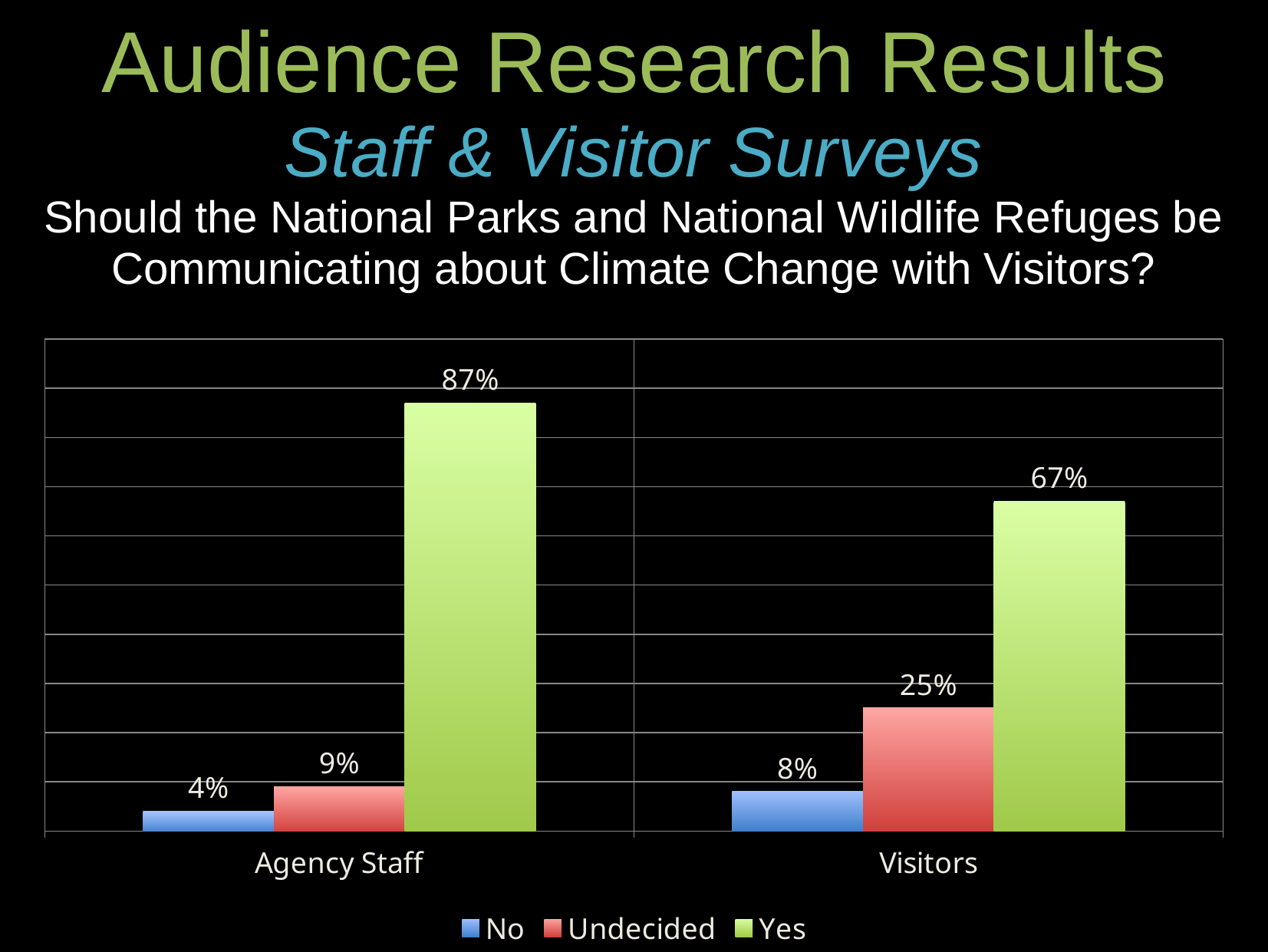
What percentage of Visitors answered Undecided? 25% How many series does the legend list? 3 What percentage of Visitors answered Yes? 67% Which response was lowest among Agency Staff? No What kind of chart is shown on the slide? Bar chart What percentage of Agency Staff answered No? 4% Which response was highest among Visitors? Yes Which colour represents the Yes response in the chart? Green What percentage of Agency Staff answered Yes? 87% What is the difference between the Yes percentage for Agency Staff and the Yes percentage for Visitors? 20% How many groups are shown on the x axis? 2 Which group had a larger Undecided percentage, Agency Staff or Visitors? Visitors